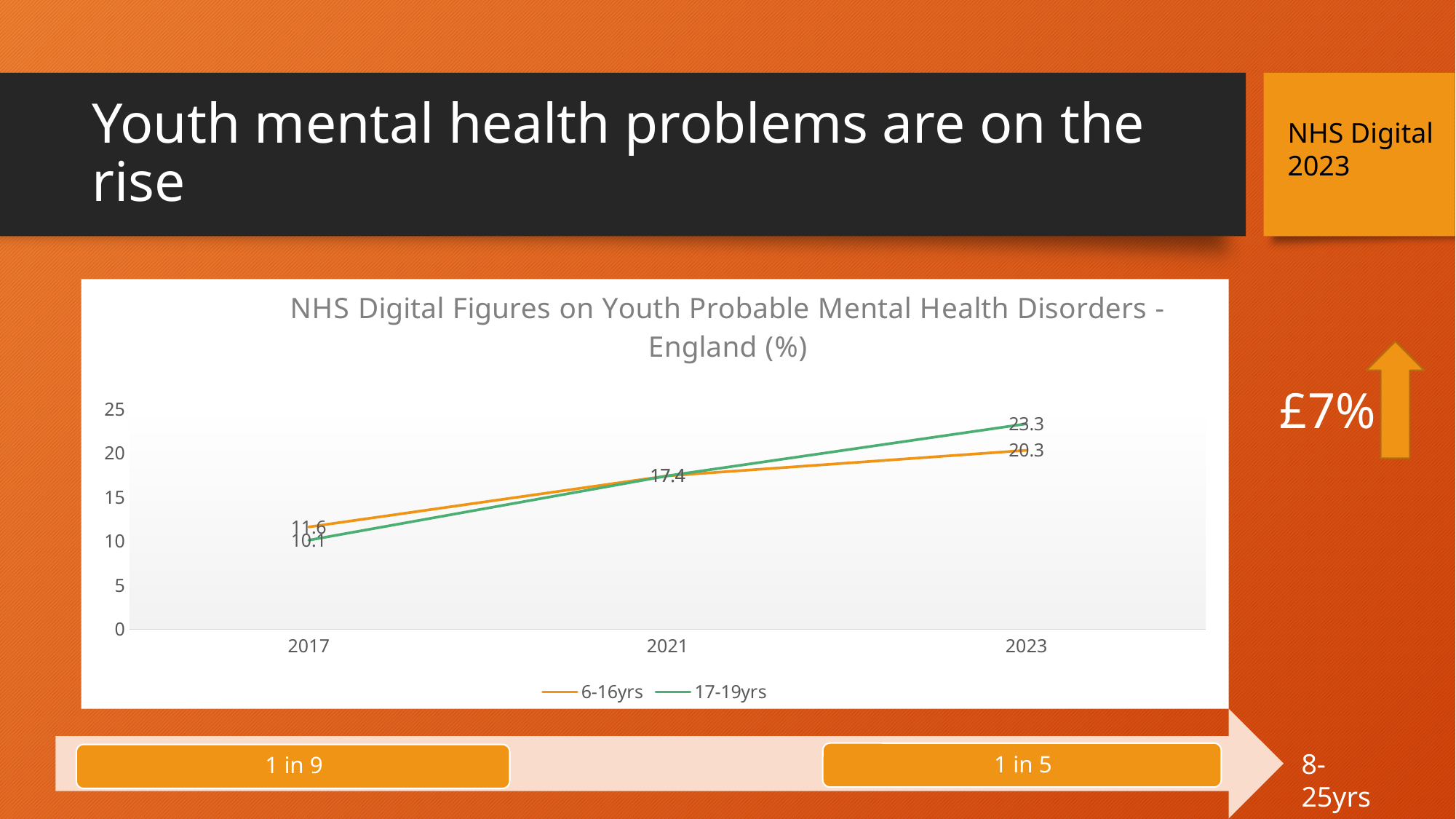
In 2023, which series has the higher value, 6-16yrs or 17-19yrs? 17-19yrs Does the 17-19yrs series rise or fall from 2017 to 2023? rise What is the value for the 17-19yrs series in 2017? 10.1 By how much did the 6-16yrs value increase from 2017 to 2023? 8.7 By how much did the 17-19yrs value increase from 2017 to 2023? 13.2 How many years are shown on the x axis of the chart? 3 In 2017, which series has the higher value, 6-16yrs or 17-19yrs? 6-16yrs How many series does the chart legend list? 2 What is the value for the 6-16yrs series in 2023? 20.3 What kind of chart is shown on the slide? line chart What is the value for the 6-16yrs series in 2017? 11.6 What is the value for the 17-19yrs series in 2023? 23.3